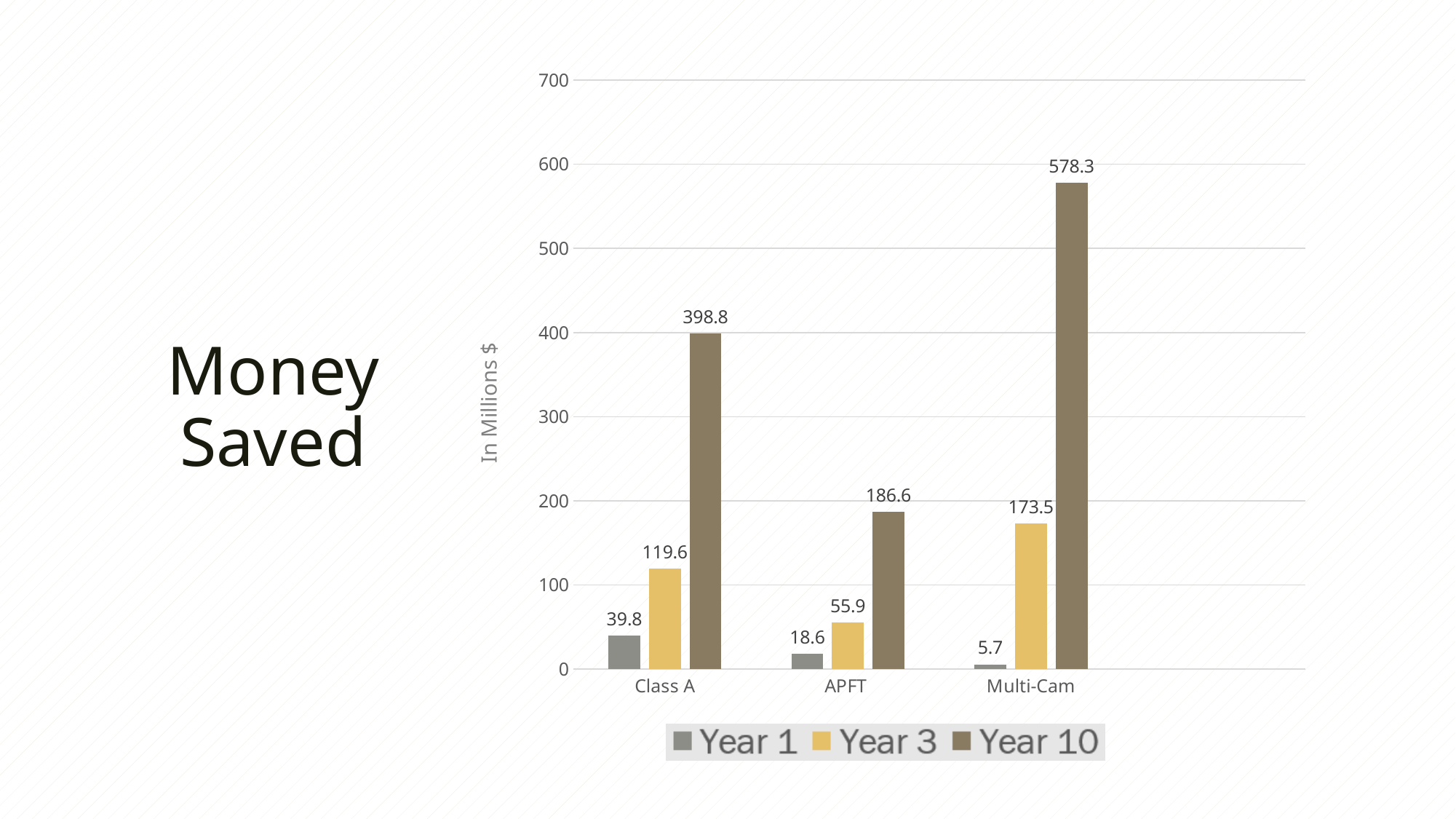
What is the Year 1 value for APFT? 18.6 What is the difference between the Year 10 values for Multi-Cam and Class A? 179.5 Which category has the lowest Year 1 value? Multi-Cam How many categories are shown on the x axis? 3 What is the Year 10 value for Multi-Cam? 578.3 How many series does the legend list? 3 What is the label of the vertical axis? In Millions $ What is the Year 3 value for Class A? 119.6 Is the Year 10 value for Class A greater or less than 300? greater Which category has the highest Year 10 value? Multi-Cam What kind of chart is shown on the slide? Bar chart Which is larger, the Year 3 value for Multi-Cam or the Year 10 value for APFT? Year 10 value for APFT